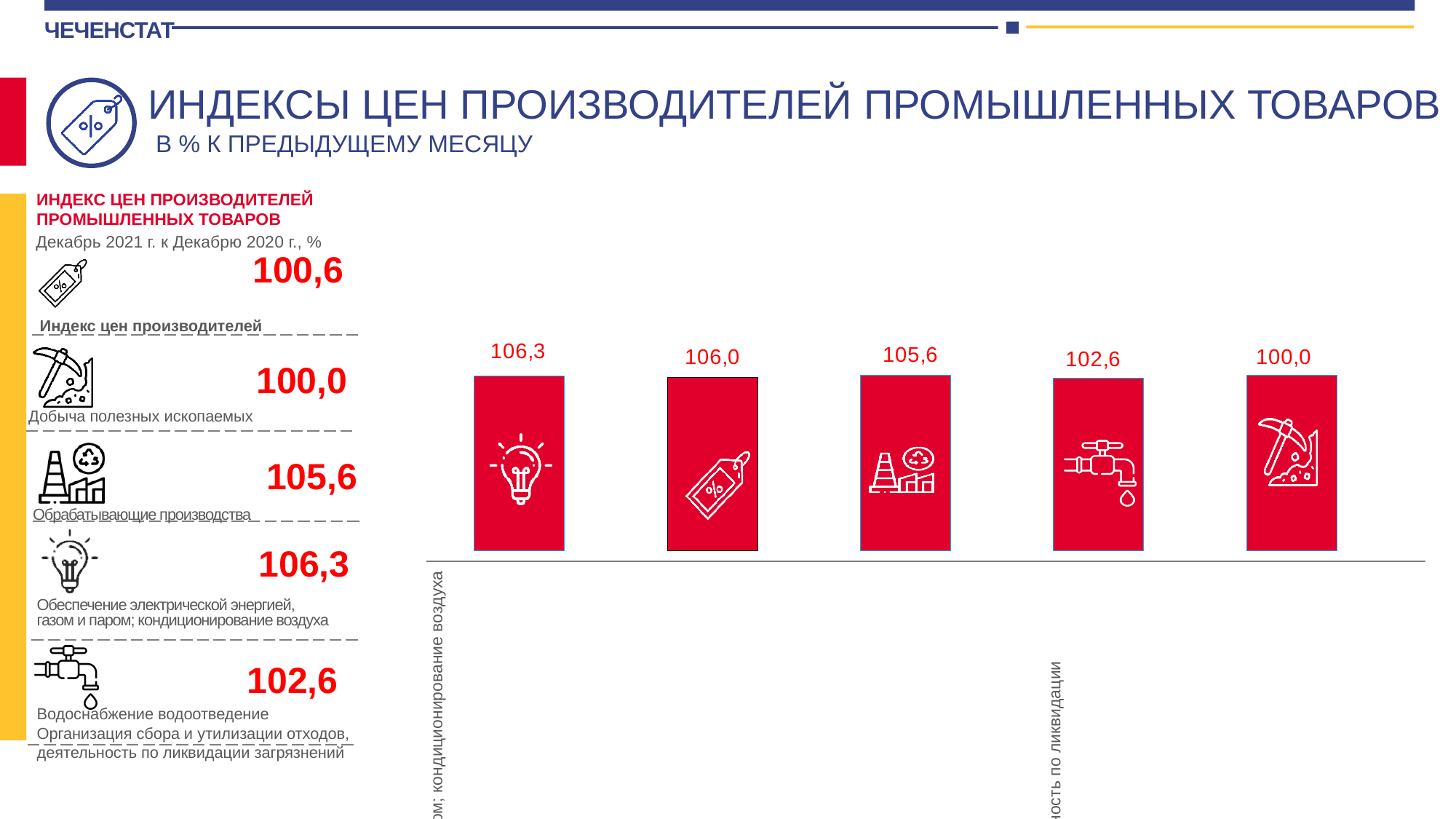
What is the value shown above the second bar in the chart? 106,0 Which bar has the highest value in the chart? the first (leftmost) bar, 106,3 What is the value shown above the first (leftmost) bar in the chart? 106,3 What is the difference between the values of the first bar (106,3) and the last bar (100,0)? 6,3 What is the value shown above the third bar in the chart? 105,6 Do the bar values rise or fall from left to right across the chart? fall What type of chart is shown on the slide? bar chart What is the value shown above the last (rightmost) bar in the chart? 100,0 How many bars are plotted in the chart? 5 What colour are the bars in the chart? red Which bar has the lowest value in the chart? the last (rightmost) bar, 100,0 What is the value shown above the fourth bar in the chart? 102,6